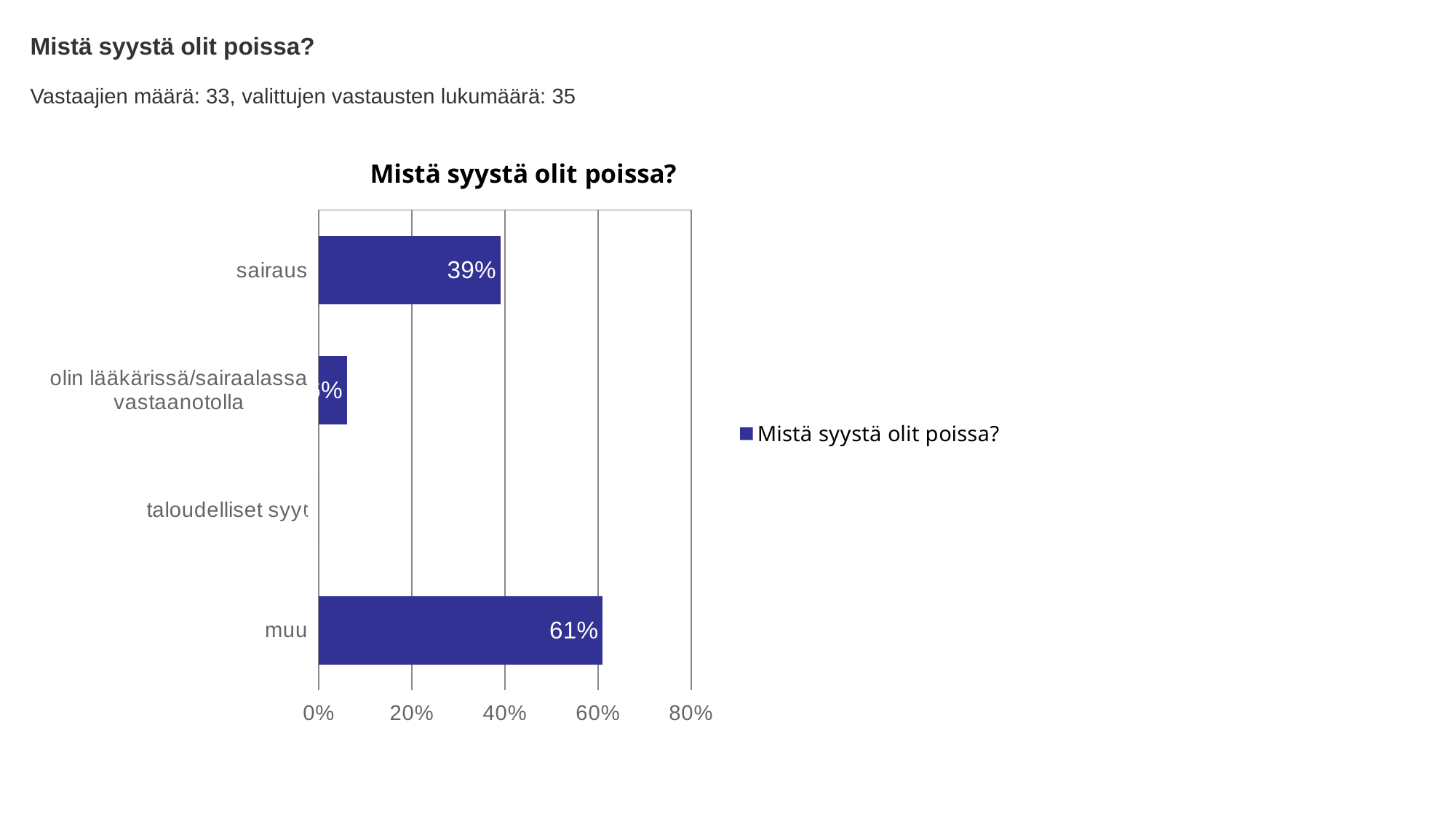
Which category has the highest value? muu What is the value for sairaus? 39% How many categories are shown on the chart? 4 Is the value for olin lääkärissä/sairaalassa vastaanotolla greater or less than 20%? less How many series does the legend list? 1 What is the title of the chart? Mistä syystä olit poissa? Which is larger, the value for sairaus or the value for muu? muu Is the value for sairaus greater or less than 20%? greater What is the value for muu? 61% What kind of chart is shown? bar chart Which category has the lowest value? taloudelliset syyt What is the difference between the values for muu and sairaus? 22%